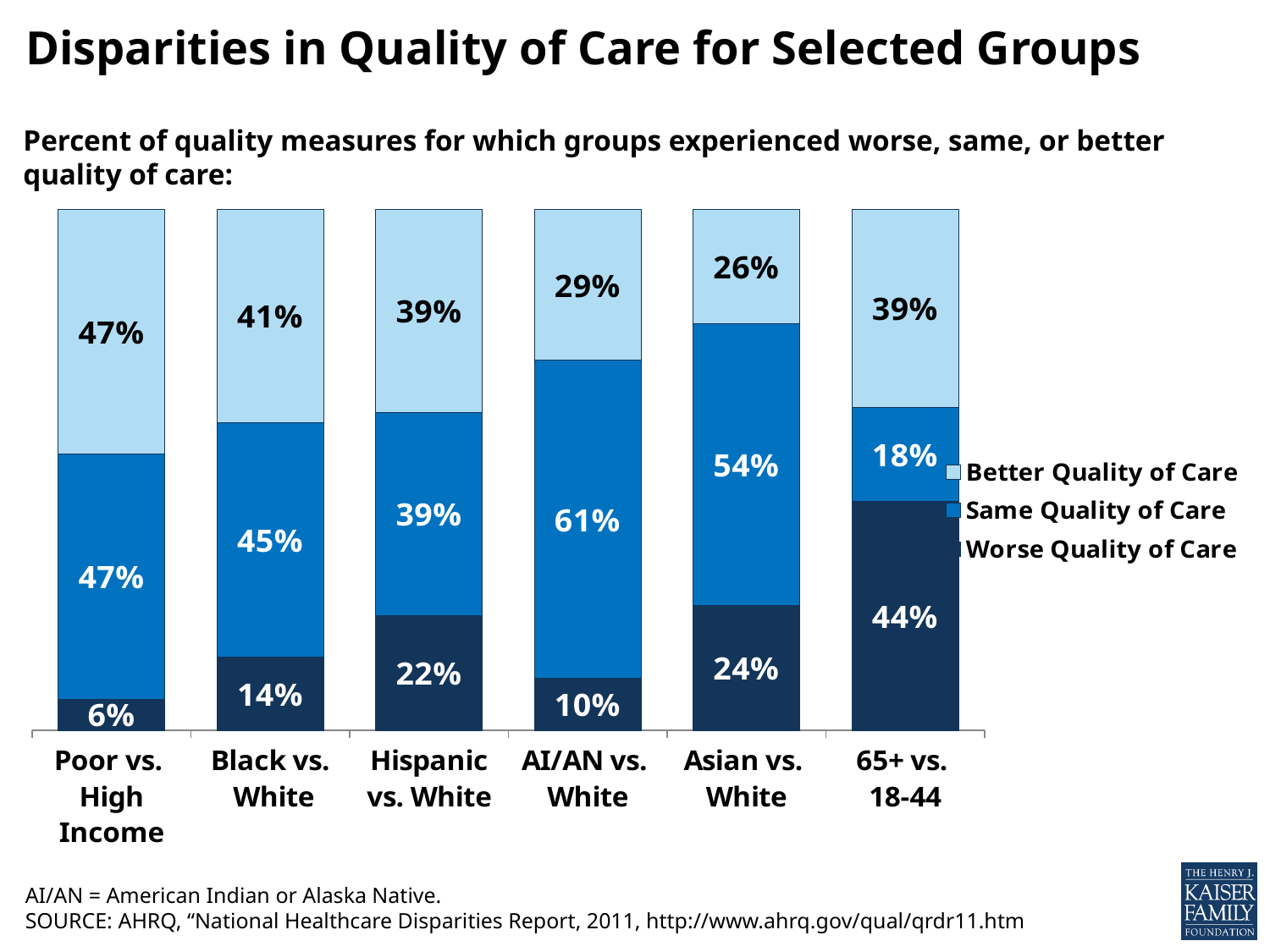
What is the Same Quality of Care value for AI/AN vs. White? 61% Which is larger: the Better Quality of Care value for Poor vs. High Income or for Hispanic vs. White? Poor vs. High Income How many groups (categories) are shown along the x axis? 6 Which group has the highest Worse Quality of Care value? 65+ vs. 18-44 What is the difference between the Worse Quality of Care values for 65+ vs. 18-44 and Black vs. White? 30% What is the Worse Quality of Care value for Poor vs. High Income? 6% Which group has the lowest Worse Quality of Care value? Poor vs. High Income How many series does the legend list? 3 Which legend entry is shown in the lightest blue colour? Better Quality of Care What is the Better Quality of Care value for Asian vs. White? 26% Which group has the highest Same Quality of Care value? AI/AN vs. White What kind of chart is shown on the slide? Stacked bar chart